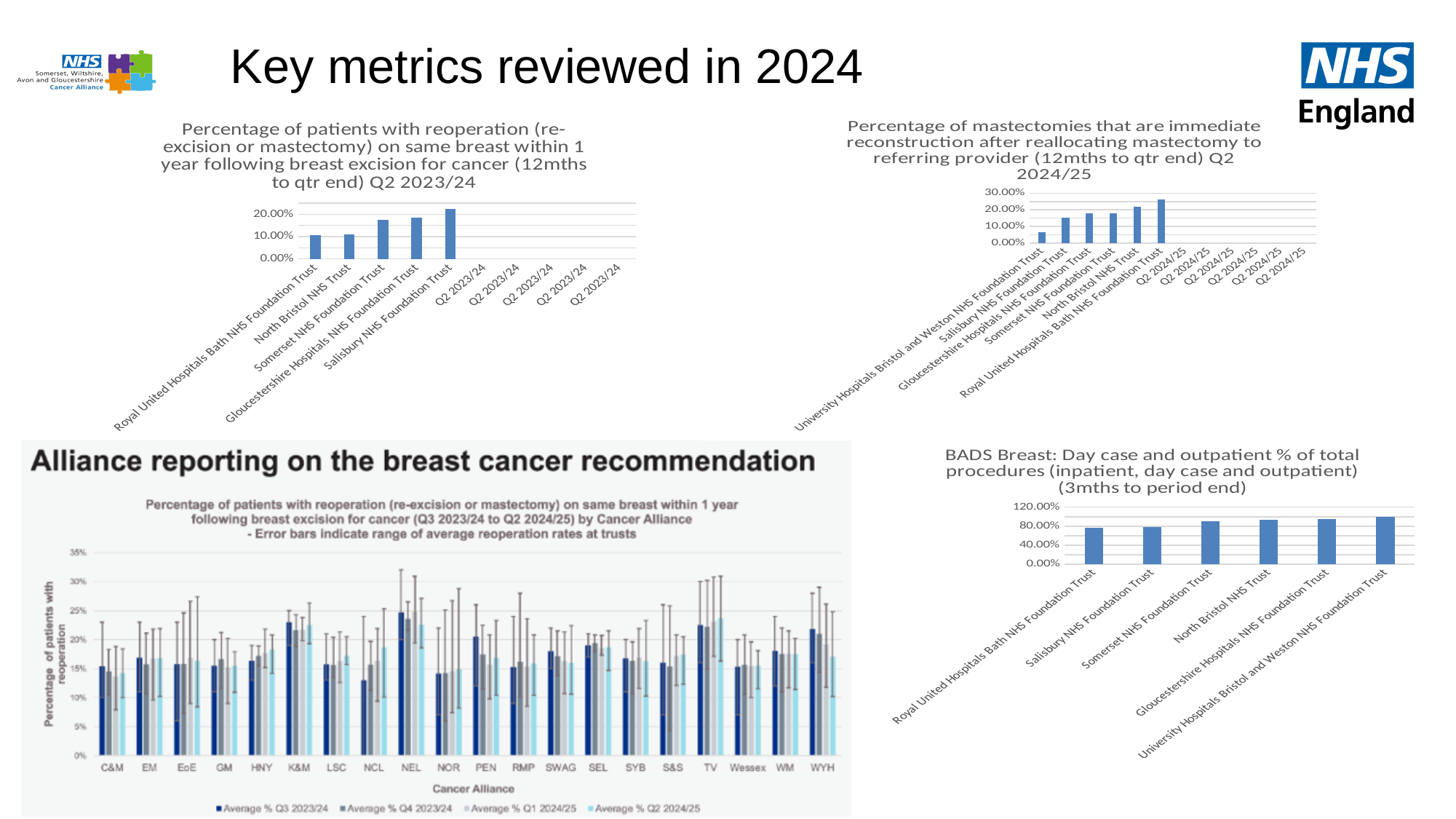
In the top-left chart (Percentage of patients with reoperation ... Q2 2023/24), is the value for Salisbury NHS Foundation Trust greater or less than 20.00%? greater In the top-left chart (Percentage of patients with reoperation ... Q2 2023/24), which trust has the highest value? Salisbury NHS Foundation Trust In the bottom-left chart (Alliance reporting on the breast cancer recommendation), how many series does the legend list? 4 In the bottom-left chart (Alliance reporting on the breast cancer recommendation), how many Cancer Alliances are shown on the x axis? 20 In the top-right chart (Percentage of mastectomies that are immediate reconstruction ... Q2 2024/25), which trust has the highest value? Royal United Hospitals Bath NHS Foundation Trust In the top-right chart (Percentage of mastectomies that are immediate reconstruction ... Q2 2024/25), how many trusts are plotted? 6 In the bottom-right chart (BADS Breast: Day case and outpatient % of total procedures), is the value for North Bristol NHS Trust greater or less than 80.00%? greater In the top-right chart (Percentage of mastectomies that are immediate reconstruction ... Q2 2024/25), is the value for Salisbury NHS Foundation Trust greater or less than 20.00%? less In the top-right chart (Percentage of mastectomies that are immediate reconstruction ... Q2 2024/25), which trust has the lowest value? University Hospitals Bristol and Weston NHS Foundation Trust In the bottom-right chart (BADS Breast: Day case and outpatient % of total procedures), which trust has the highest value? University Hospitals Bristol and Weston NHS Foundation Trust